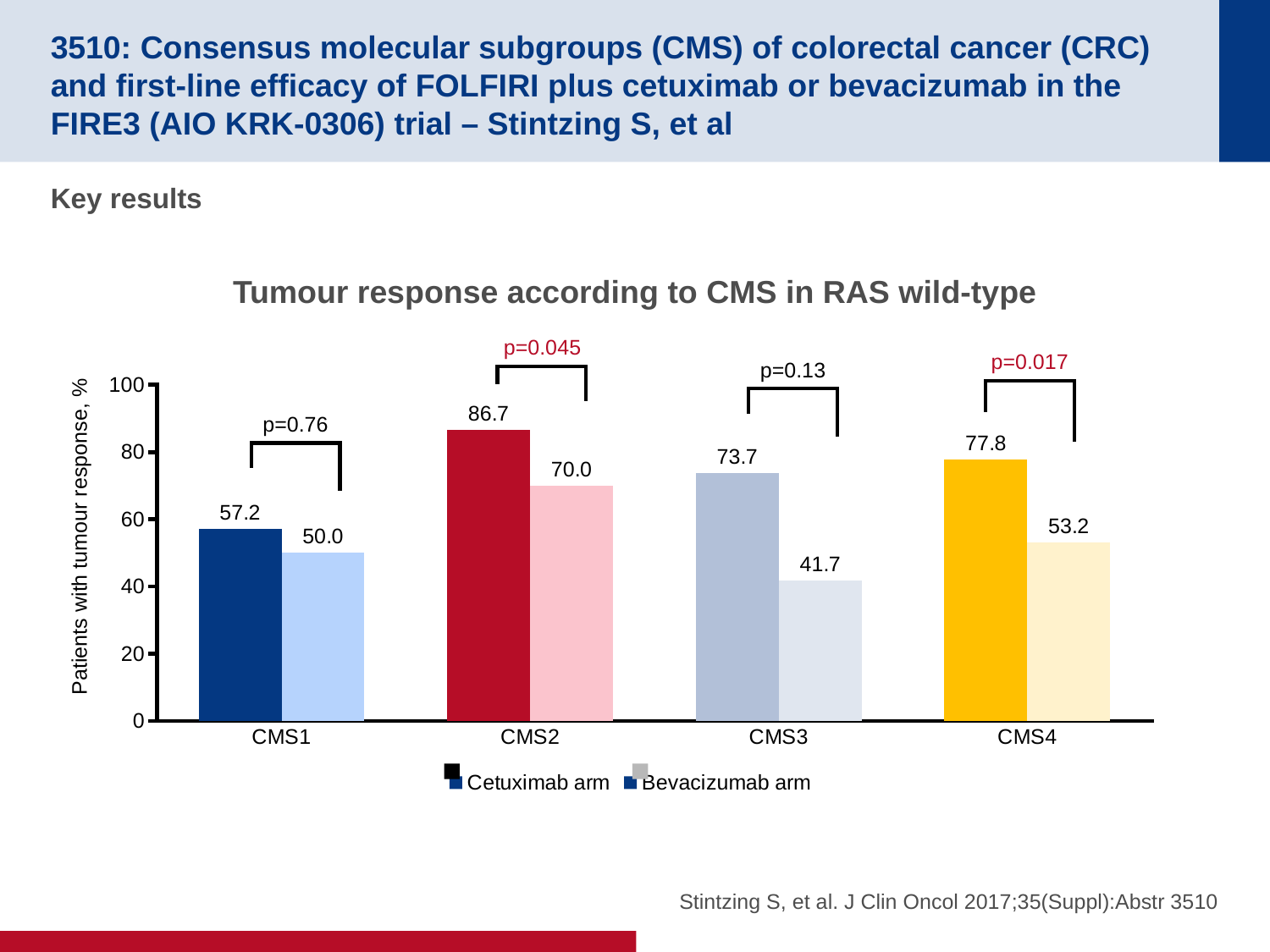
What p-value is shown for the comparison in CMS2? p=0.045 What is the difference between the cetuximab arm and bevacizumab arm response rates in CMS3? 32.0 What is the tumour response rate for the bevacizumab arm in CMS4? 53.2 What is the tumour response rate for the cetuximab arm in CMS2? 86.7 How many series does the legend list? 2 Which CMS subgroup has the highest tumour response rate in the cetuximab arm? CMS2 Which CMS subgroup has the lowest tumour response rate in the bevacizumab arm? CMS3 What type of chart is shown? Bar chart Which arm has the higher tumour response rate in CMS4? Cetuximab arm What is the tumour response rate for the bevacizumab arm in CMS3? 41.7 What is the difference between the cetuximab arm and bevacizumab arm response rates in CMS1? 7.2 How many CMS subgroups are shown on the x axis? 4